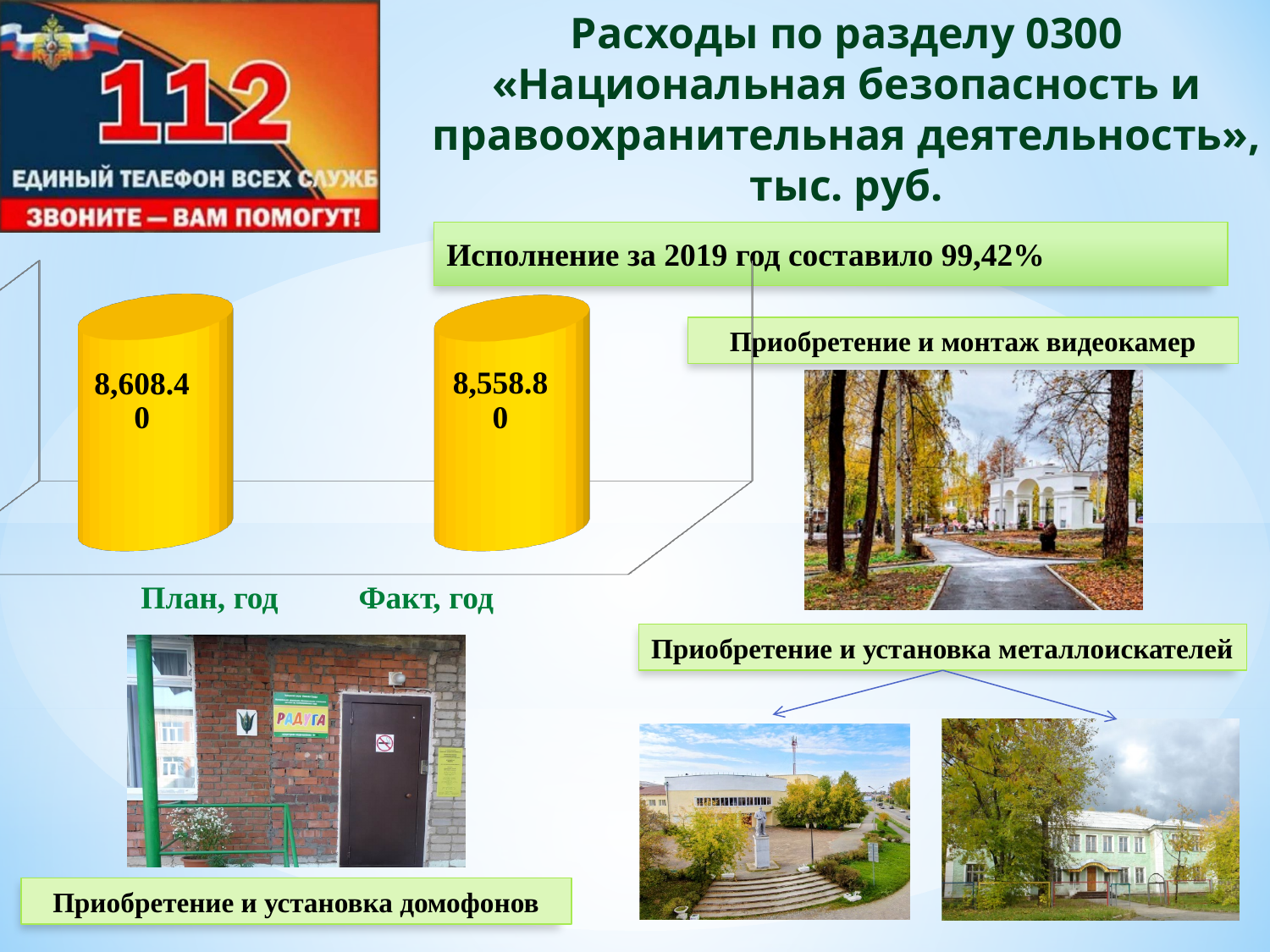
Do the values rise or fall from «План, год» to «Факт, год»? Fall Which category has the highest value in the chart? План, год In what units are the chart values expressed, according to the slide title? тыс. руб. What is the value for «План, год» in the chart? 8,608.40 What is the value for «Факт, год» in the chart? 8,558.80 What is the difference between the «План, год» and «Факт, год» values? 49.60 What kind of chart is shown on the slide? Bar chart Which category has the lowest value in the chart? Факт, год How many categories are plotted in the chart? 2 What colour are the bars in the chart? Yellow Which category has the higher value, «План, год» or «Факт, год»? План, год